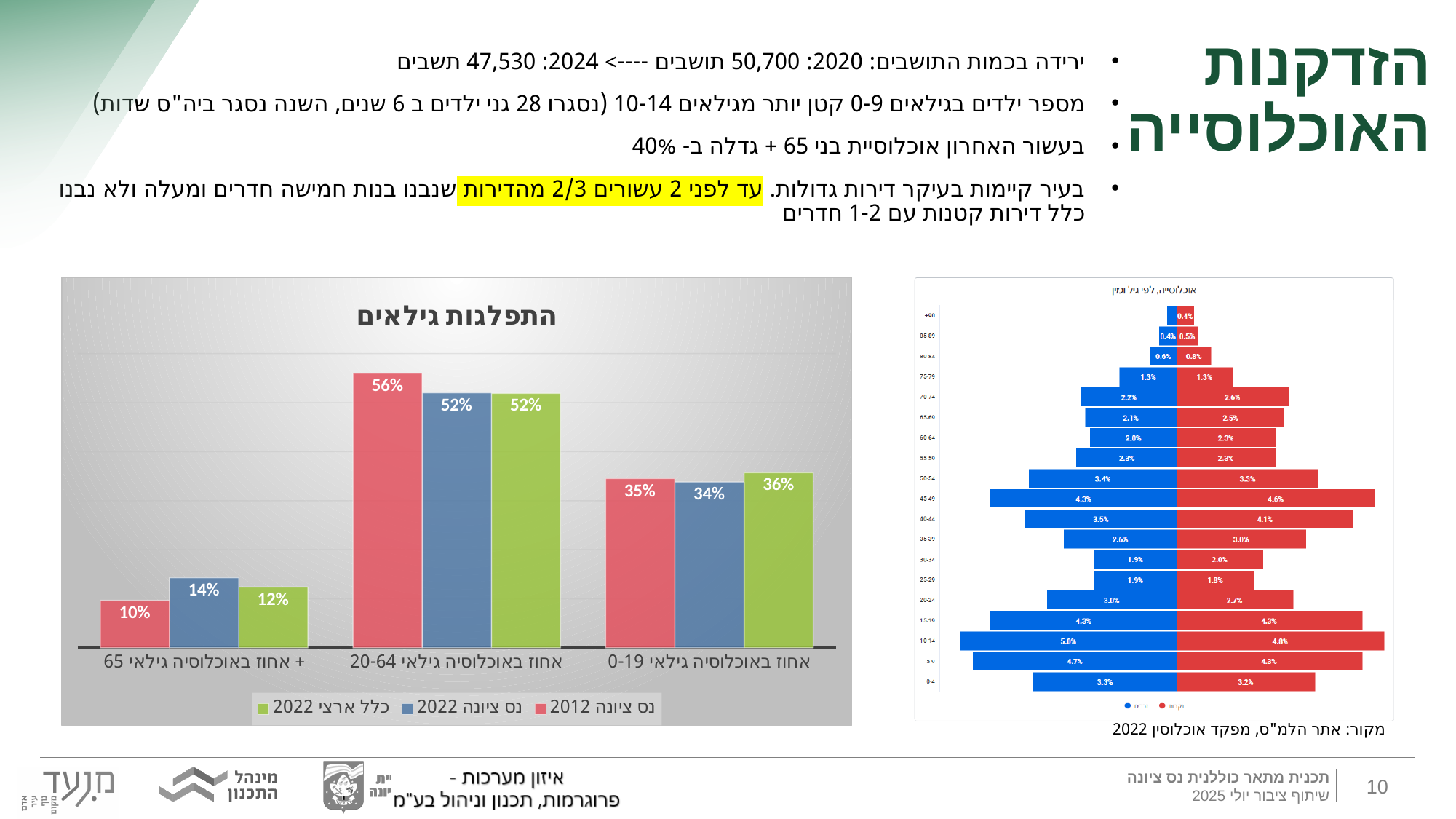
How many age groups are shown in the population pyramid chart on the right? 19 In the 'התפלגות גילאים' chart, what is the value for נס ציונה 2012 in the 20-64 age group? 56% In the 'התפלגות גילאים' chart, what is the difference between נס ציונה 2012 and נס ציונה 2022 in the 20-64 age group? 4% In the 'התפלגות גילאים' chart, which is larger for the 0-19 age group: נס ציונה 2012 or נס ציונה 2022? נס ציונה 2012 In the 'התפלגות גילאים' chart, which series has the highest value in the 65+ age group? נס ציונה 2022 In the population pyramid chart on the right, which age group has the highest value for males (זכרים)? 10-14 How many series does the legend of the 'התפלגות גילאים' chart list? 3 What kind of chart is the 'התפלגות גילאים' chart? bar chart In the 'התפלגות גילאים' chart, what is the value for כלל ארצי 2022 in the 0-19 age group? 36% In the 'התפלגות גילאים' chart, what is the value for נס ציונה 2022 in the 65+ age group? 14%